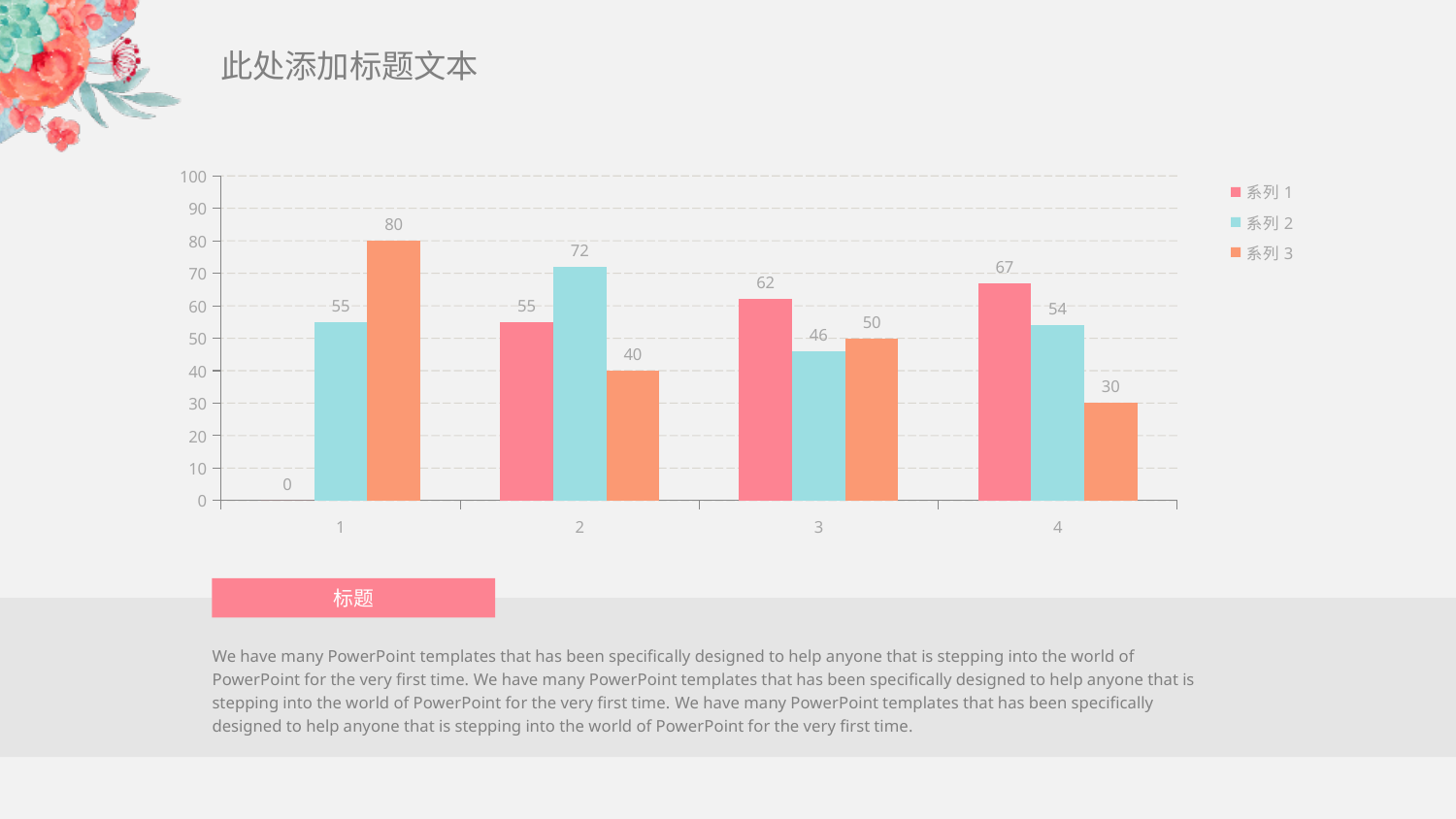
How many series does the legend list? 3 Do the values for 系列 3 rise or fall from category 2 to category 4? They rise then fall (40, 50, 30) Which category has the highest value for 系列 1? 4 What is the difference between 系列 2 and 系列 3 for category 2? 32 What kind of chart is shown on the slide? Bar chart What is the value of 系列 2 for category 2? 72 For category 3, which is larger: 系列 1 or 系列 2? 系列 1 What is the value of 系列 1 for category 1? 0 What is the value of 系列 1 for category 4? 67 Which category has the lowest value for 系列 3? 4 How many categories are shown on the x axis? 4 What is the value of 系列 3 for category 1? 80